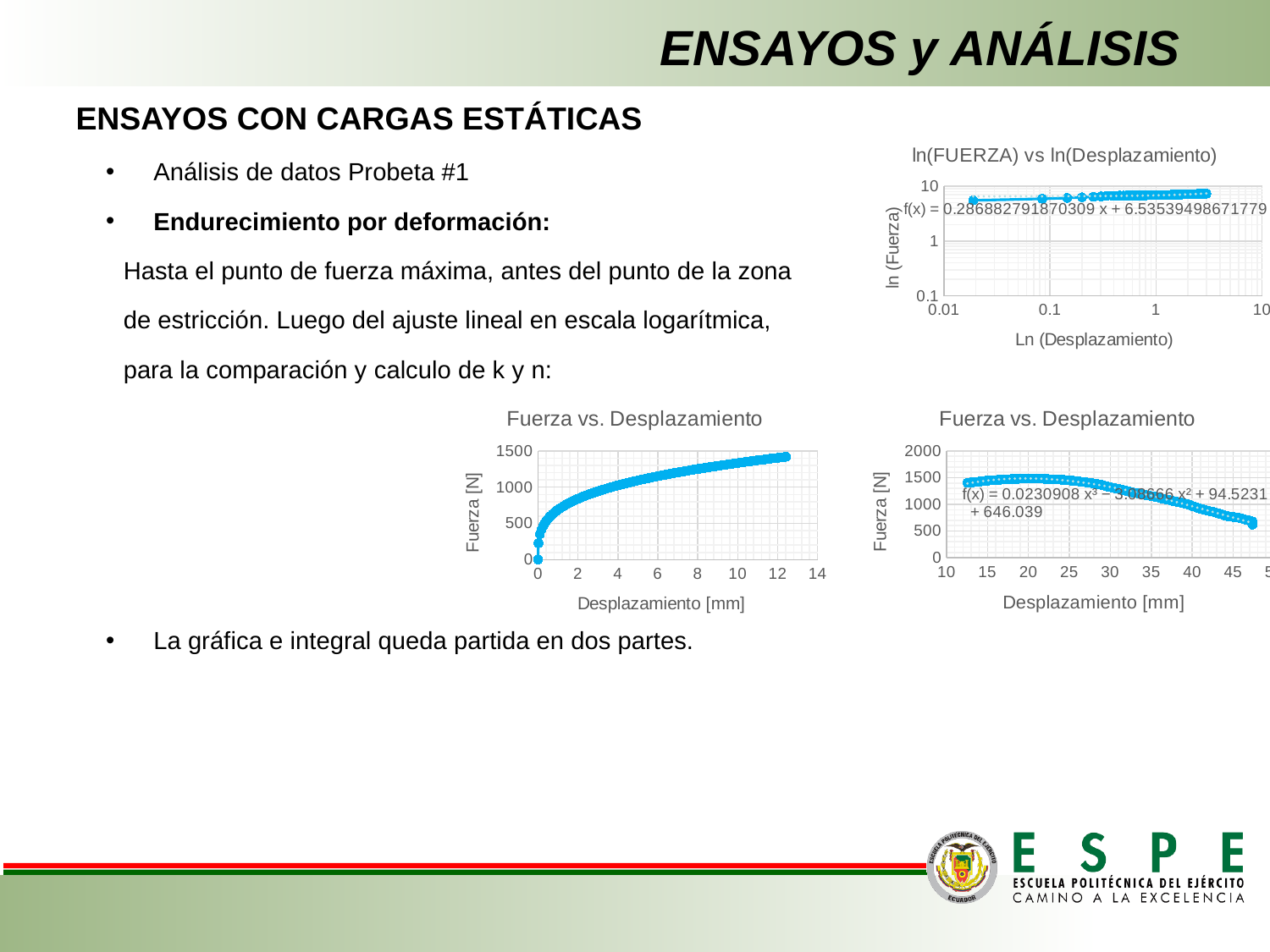
In the bottom-middle 'Fuerza vs. Desplazamiento' chart, is the Fuerza at 2 mm greater or less than 1000? less In the bottom-right 'Fuerza vs. Desplazamiento' chart, which has the larger Fuerza: the point at 20 mm or the point at 45 mm? 20 mm What is the slope of the linear fit f(x) shown on the top-right 'ln(FUERZA) vs ln(Desplazamiento)' chart? 0.286882791870309 In the bottom-right 'Fuerza vs. Desplazamiento' chart, is the Fuerza at 20 mm greater or less than 1000? greater In the bottom-right 'Fuerza vs. Desplazamiento' chart, is the Fuerza at 45 mm greater or less than 1000? less How many charts are shown on the slide? 3 What kind of chart is the bottom-middle 'Fuerza vs. Desplazamiento' chart? Scatter chart What is the y-axis label of the bottom-middle 'Fuerza vs. Desplazamiento' chart? Fuerza [N] In the bottom-middle 'Fuerza vs. Desplazamiento' chart, do the values rise or fall as Desplazamiento increases? Rise What is the title of the chart in the top-right of the slide? ln(FUERZA) vs ln(Desplazamiento) In the bottom-right 'Fuerza vs. Desplazamiento' chart, do the values rise or fall between 30 mm and 45 mm of Desplazamiento? Fall